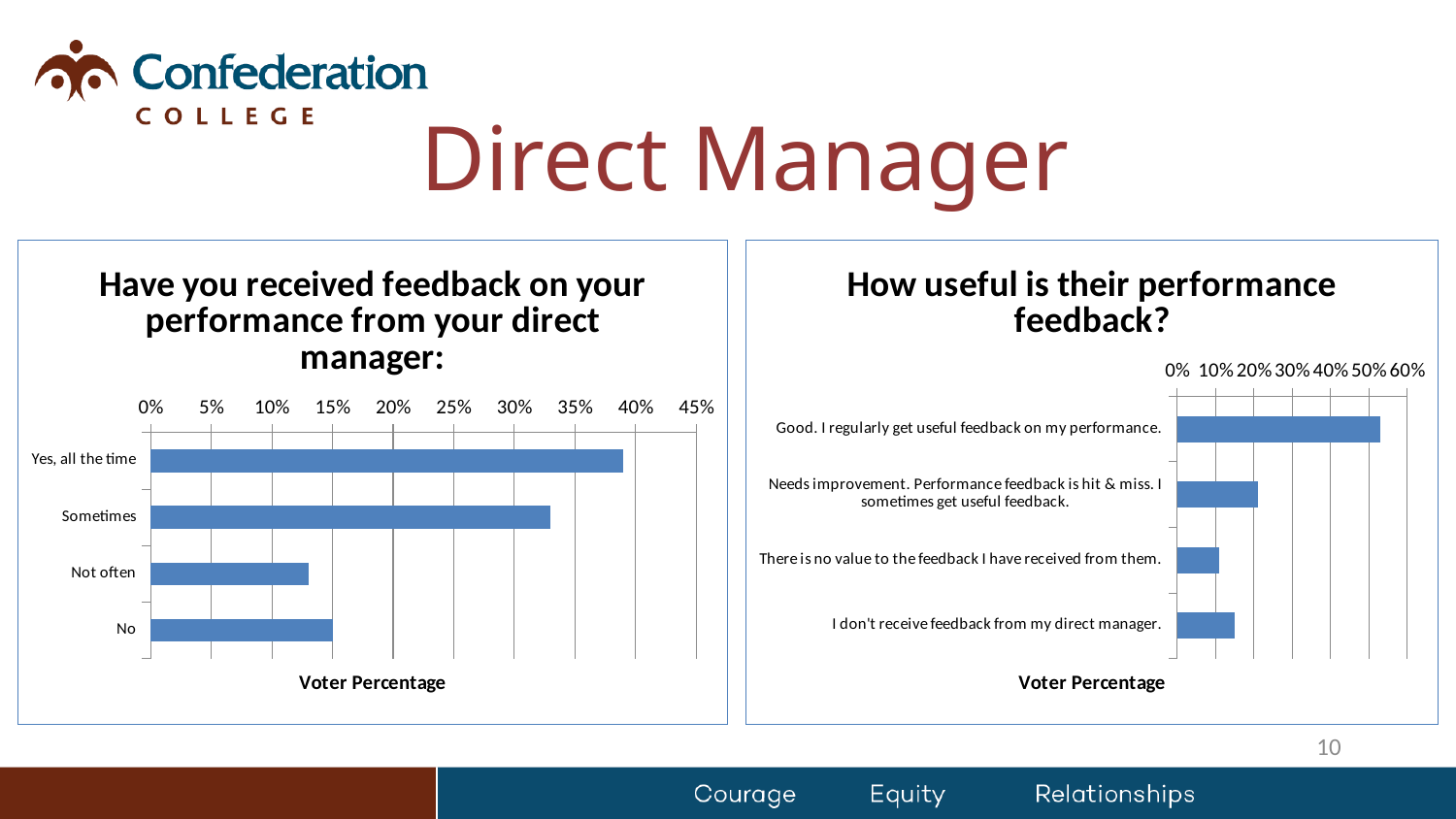
In the 'How useful is their performance feedback?' chart, is the value for 'Good. I regularly get useful feedback on my performance.' greater or less than 50%? greater In the 'How useful is their performance feedback?' chart, is the value for 'Needs improvement. Performance feedback is hit & miss. I sometimes get useful feedback.' greater or less than 30%? less How many categories are shown in the 'Have you received feedback on your performance from your direct manager' chart? 4 In the 'Have you received feedback on your performance from your direct manager' chart, which category has the highest value? Yes, all the time In the 'Have you received feedback on your performance from your direct manager' chart, which category has the lowest value? Not often What is the x-axis title of the 'How useful is their performance feedback?' chart? Voter Percentage In the 'Have you received feedback on your performance from your direct manager' chart, is the value for 'Yes, all the time' greater or less than 35%? greater What kind of chart is the 'Have you received feedback on your performance from your direct manager' chart? Bar chart In the 'Have you received feedback on your performance from your direct manager' chart, which is larger: 'Sometimes' or 'No'? Sometimes How many categories are shown in the 'How useful is their performance feedback?' chart? 4 In the 'How useful is their performance feedback?' chart, which category has the highest value? Good. I regularly get useful feedback on my performance.